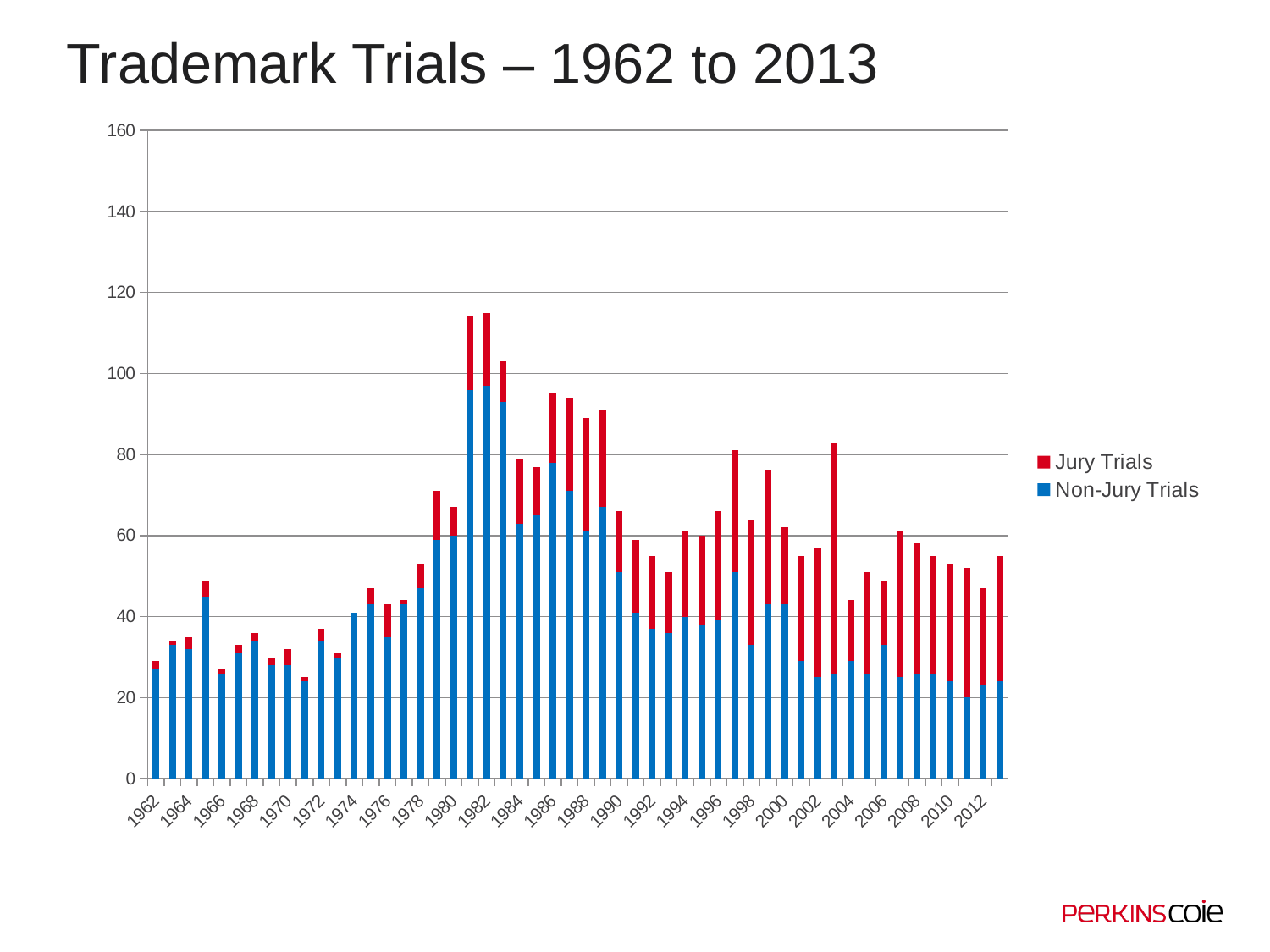
What are the two series named in the legend? Jury Trials and Non-Jury Trials Do the total trials generally rise or fall from 1982 to 1990? Fall Which colour represents Jury Trials in the chart? Red Is the total number of trials for 1982 greater or less than 100? greater Which year has more Non-Jury Trials, 1981 or 2011? 1981 Is the total number of trials for 1962 greater or less than 40? less Which year has the larger total number of trials, 1982 or 2013? 1982 Is the number of Non-Jury Trials for 2011 greater or less than 40? less How many series does the legend list? 2 What kind of chart is shown on the slide? Stacked bar chart How many years (bars) are plotted in the chart? 52